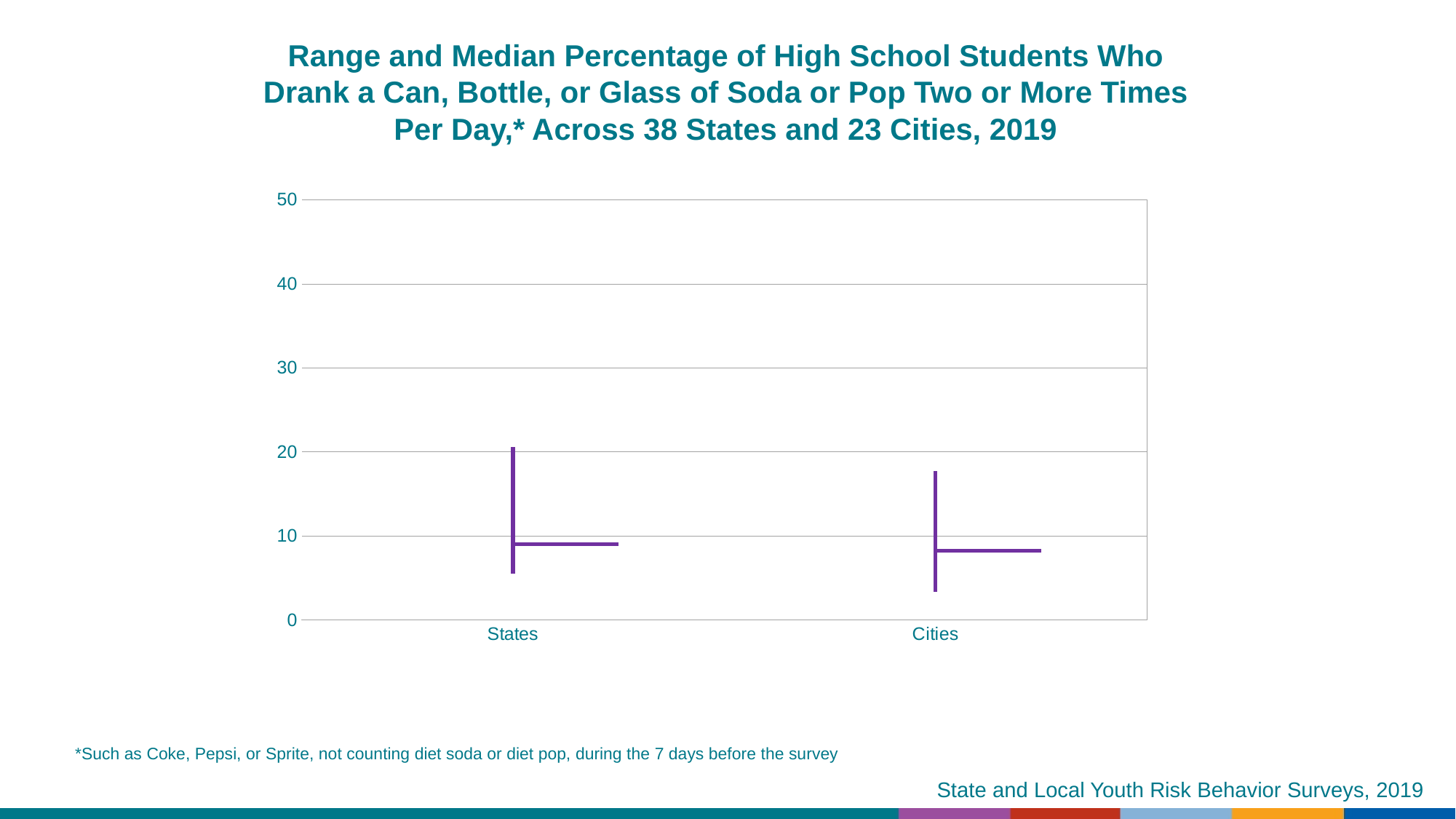
Which category has the higher maximum (top of the range) in the chart? States Is the top of the range for Cities greater or less than 20? less Which category has the lower minimum (bottom of the range) in the chart? Cities Is the median for Cities greater or less than 10? less What is the highest value shown on the y axis of the chart? 50 What are the two categories shown on the x axis? States and Cities Is the top of the range for States greater or less than 15? greater How many categories are shown on the x axis of the chart? 2 According to the title, how many states and cities does the chart cover? 38 states and 23 cities